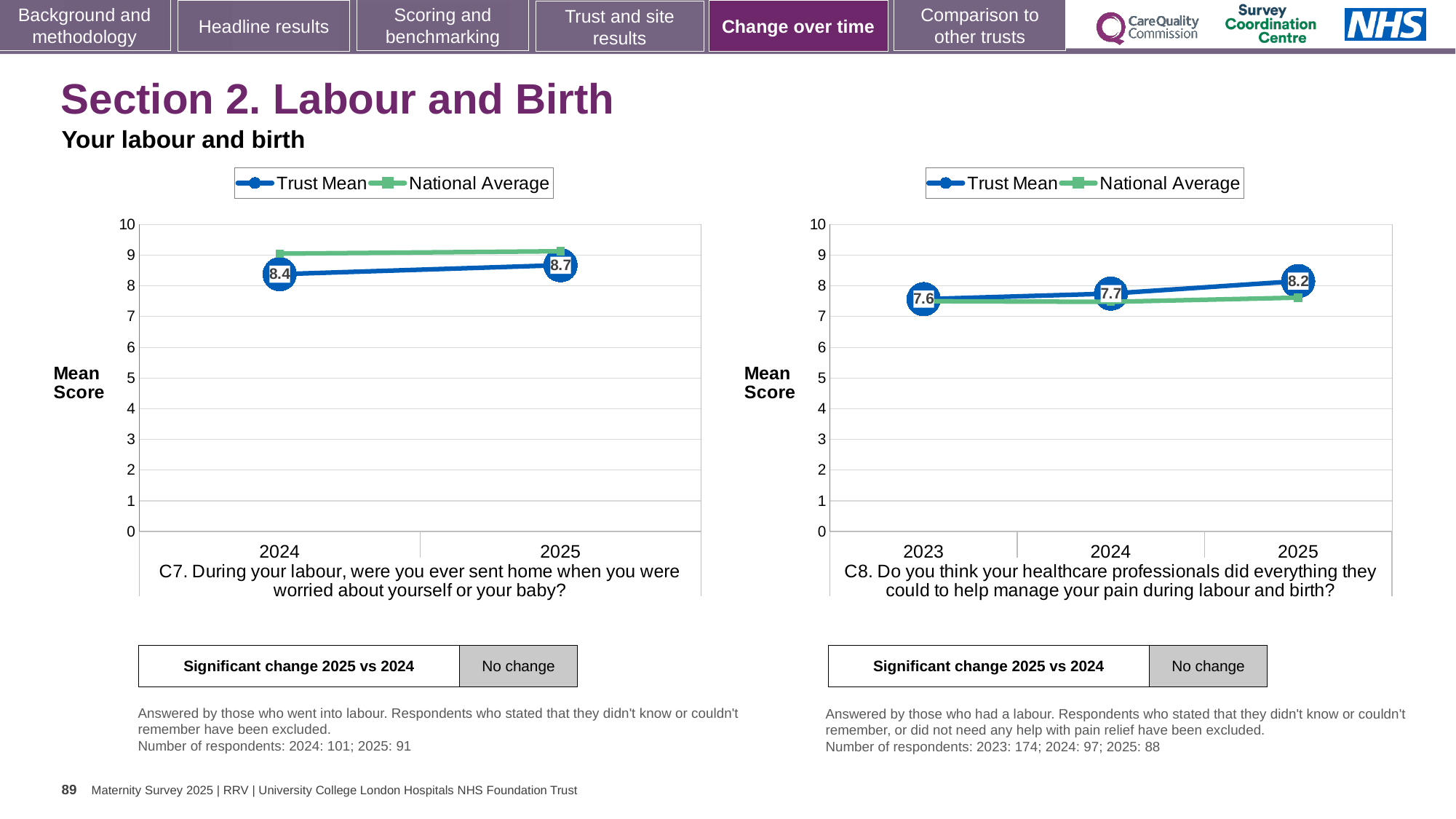
In the C7 chart (left), by how much did the Trust Mean increase from 2024 to 2025? 0.3 In the C8 chart (right), which year has the highest Trust Mean? 2025 In the C7 chart (left), what is the Trust Mean for 2024? 8.4 In the C8 chart (right), what is the Trust Mean for 2025? 8.2 In the C7 chart (left), what is the Trust Mean for 2025? 8.7 What kind of chart is the C8 chart (right)? Line chart In the C7 chart (left), is the National Average for 2024 greater or less than 8? greater In the C8 chart (right), what is the Trust Mean for 2023? 7.6 How many series does the legend of the C7 chart (left) list? 2 In the C8 chart (right), which year has the lowest Trust Mean? 2023 How many years are shown on the x axis of the C8 chart (right)? 3 In the C8 chart (right), by how much did the Trust Mean change from 2023 to 2025? 0.6